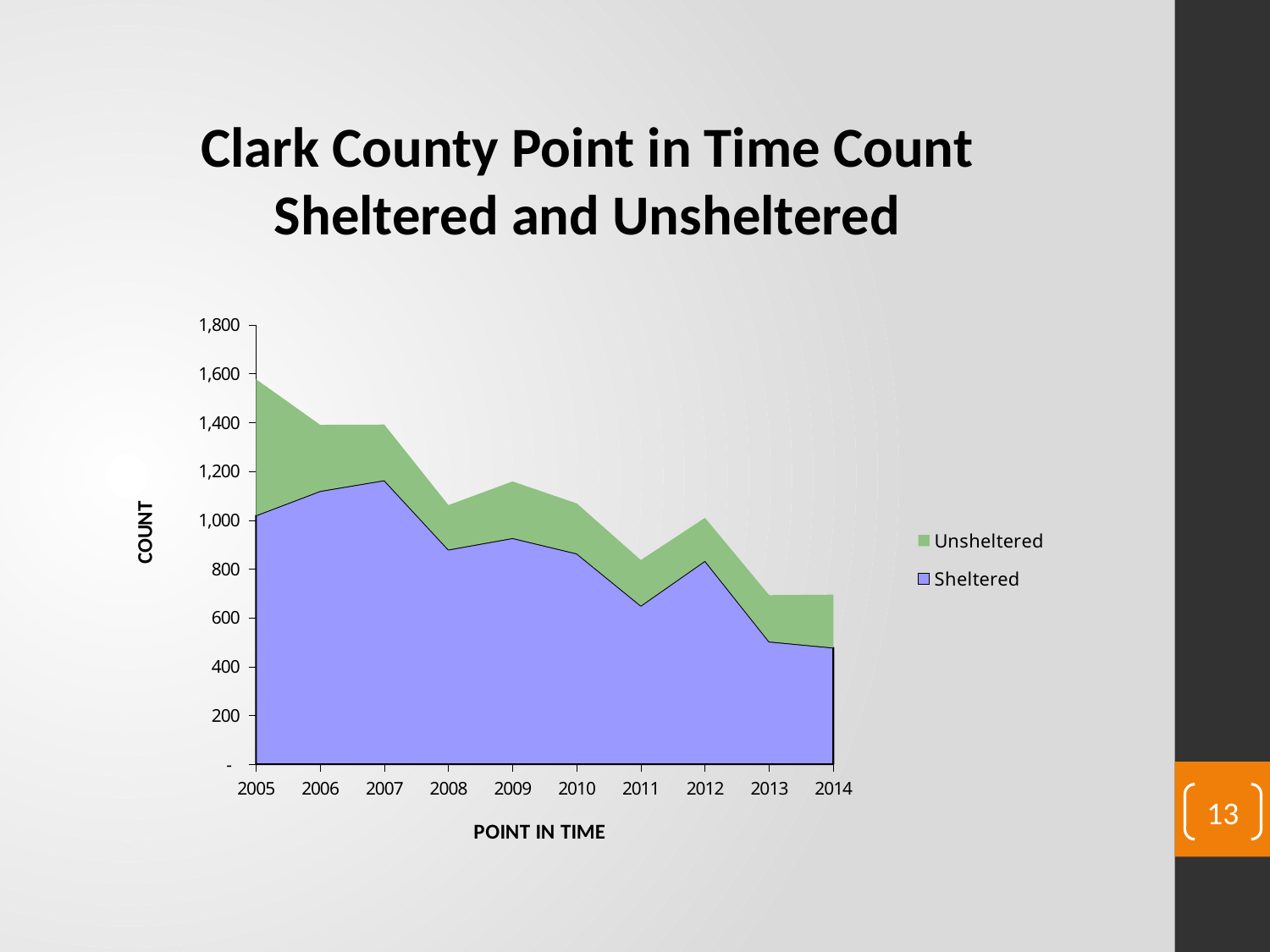
How many years are shown along the x axis? 10 Is the Sheltered count for 2011 greater or less than 800? less What kind of chart is shown on the slide? Stacked area chart Which year has the highest total (Sheltered plus Unsheltered) count? 2005 Overall, does the Sheltered count rise or fall from 2005 to 2014? fall Which series is shown in green? Unsheltered Is the Sheltered count for 2007 greater or less than 1,000? greater How many series does the legend list? 2 Is the Sheltered count larger in 2012 or in 2013? 2012 Is the total count (Sheltered plus Unsheltered) for 2014 greater or less than 800? less In which year is the Sheltered count highest? 2007